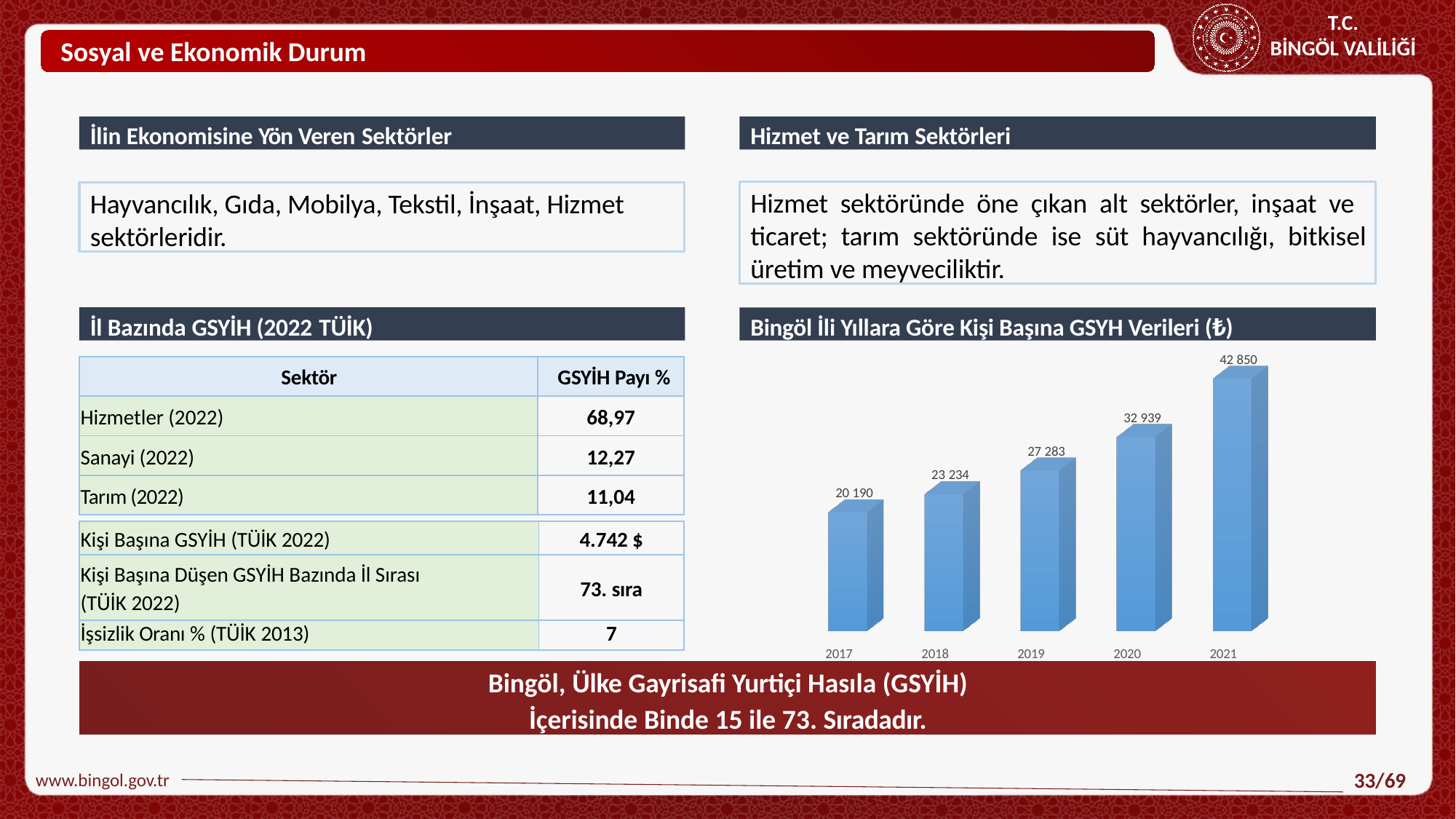
Which is larger in the chart, the value for 2018 or the value for 2019? 2019 How many years (bars) are shown in the chart? 5 What is the difference between the 2021 value and the 2017 value in the chart? 22 660 By how much did the value increase from 2019 to 2020? 5 656 Do the values in the chart rise or fall from 2017 to 2021? Rise What is the value plotted for 2019? 27 283 What kind of chart is used to show the per capita GDP data? Bar chart Which year has the lowest value in the chart? 2017 What is the per capita GDP value shown for 2021 in the chart? 42 850 Which year has the highest per capita GDP value in the chart? 2021 What value does the chart show for 2017? 20 190 What value is labelled on the bar for 2020? 32 939